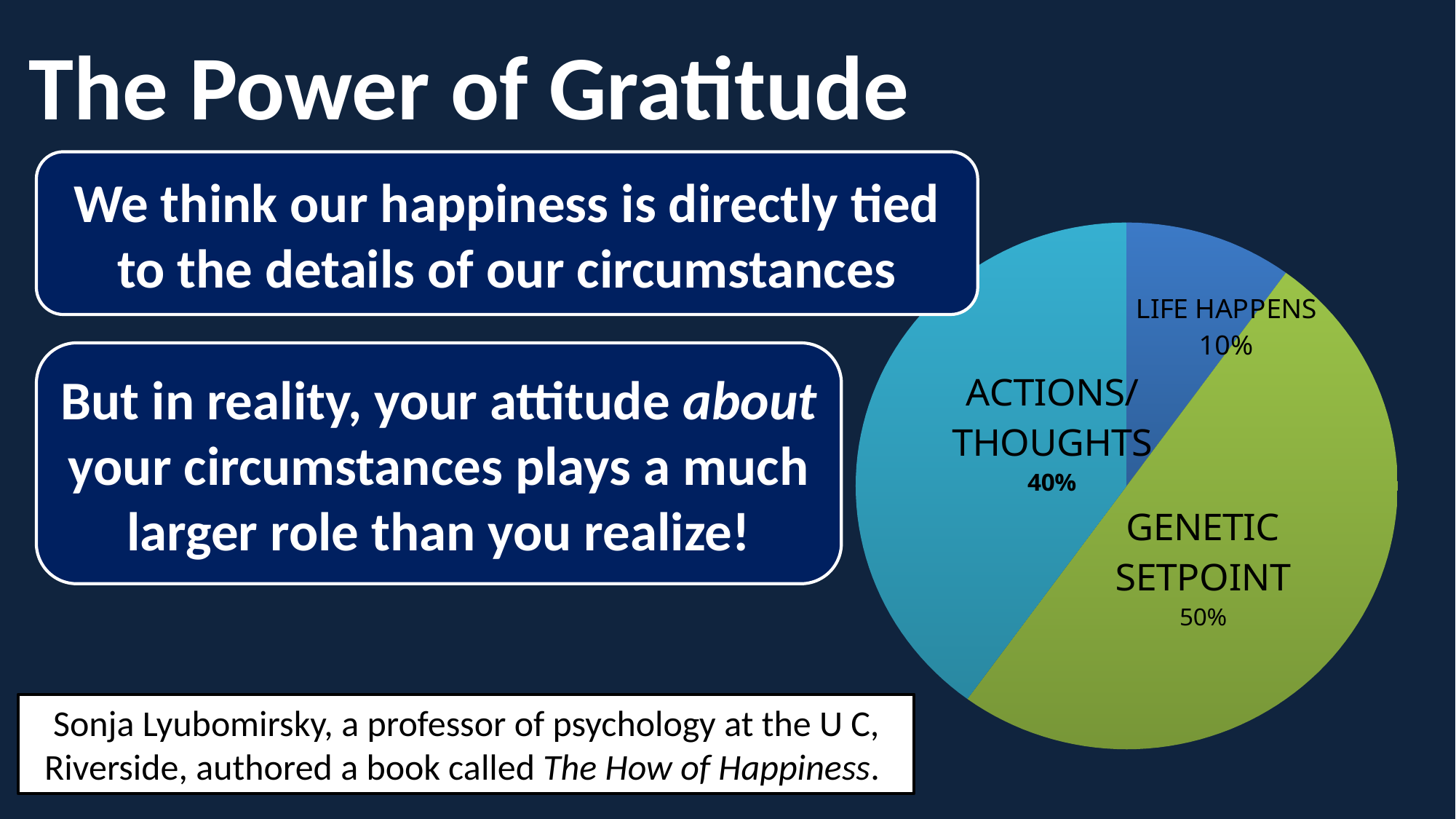
What is the difference in percentage points between GENETIC SETPOINT and ACTIONS/THOUGHTS? 10 What percentage does the LIFE HAPPENS slice represent? 10% What share of the pie does the LIFE HAPPENS slice take up? 10% How many slices does the pie chart have? 3 What is the difference in percentage points between ACTIONS/THOUGHTS and LIFE HAPPENS? 30 Which slice of the pie chart is the largest? GENETIC SETPOINT What percentage does the ACTIONS/THOUGHTS slice represent? 40% Which slice of the pie chart is the smallest? LIFE HAPPENS What percentage does the GENETIC SETPOINT slice represent? 50% What kind of chart is shown on the slide? pie chart Which is larger, the ACTIONS/THOUGHTS slice or the LIFE HAPPENS slice? ACTIONS/THOUGHTS What colour is the GENETIC SETPOINT slice? green